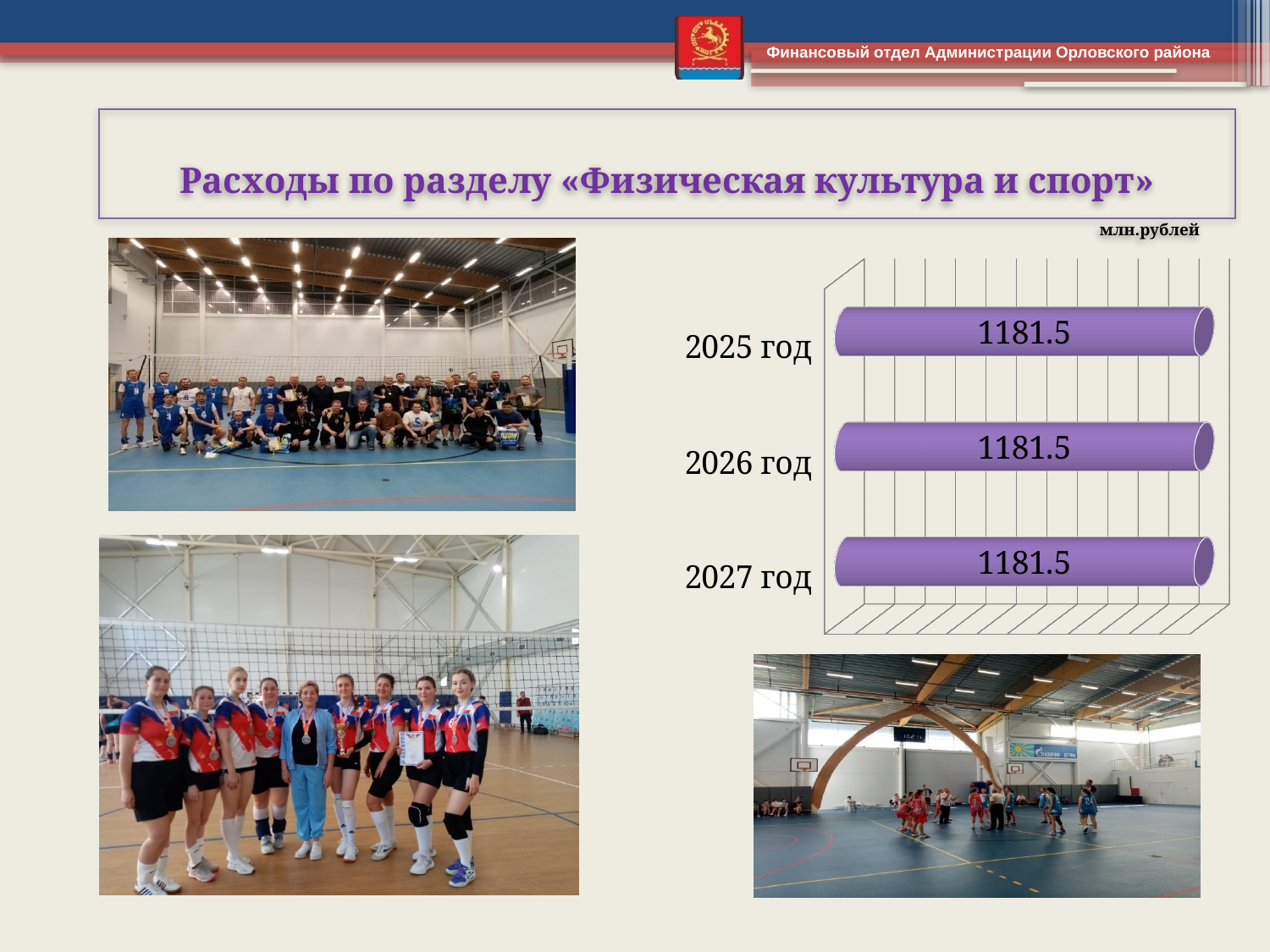
Do the values rise, fall or stay the same from 2025 год to 2027 год? Stay the same How many categories (years) are shown in the chart? 3 What is the difference between the values for 2025 год and 2027 год? 0 What unit of measurement is indicated for the chart? млн.рублей What is the value for 2026 год? 1181.5 What is the value for 2027 год? 1181.5 What kind of chart is shown on the slide? Bar chart Is the value for 2026 год greater or less than 1000? greater What is the value for 2025 год? 1181.5 What is the title of the slide containing the chart? Расходы по разделу «Физическая культура и спорт»